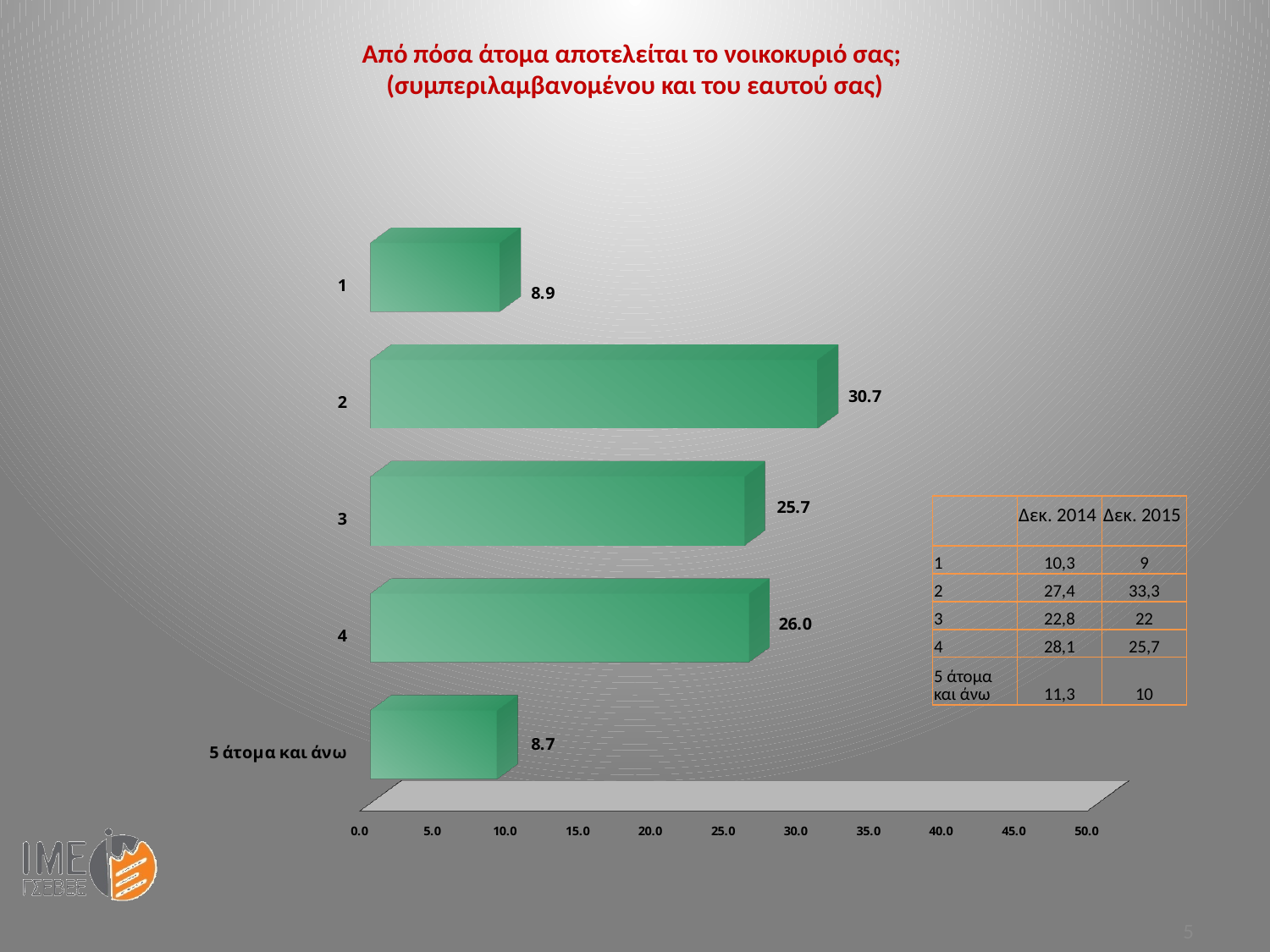
What kind of chart is shown on the slide? bar chart Which has a larger value in the bar chart, category 3 or category 4? 4 Which category has the lowest value in the bar chart? 5 άτομα και άνω Which category has the highest value in the bar chart? 2 What is the value shown for category 2 in the bar chart? 30.7 What is the difference between the values for category 4 and category 3 in the bar chart? 0.3 How many categories are shown in the bar chart? 5 What is the value shown for category 4 in the bar chart? 26.0 What is the value shown for category 1 in the bar chart? 8.9 Is the value for category 3 in the bar chart greater or less than 20.0? greater What is the difference between the values for category 2 and category 1 in the bar chart? 21.8 What is the value shown for the category '5 άτομα και άνω' in the bar chart? 8.7